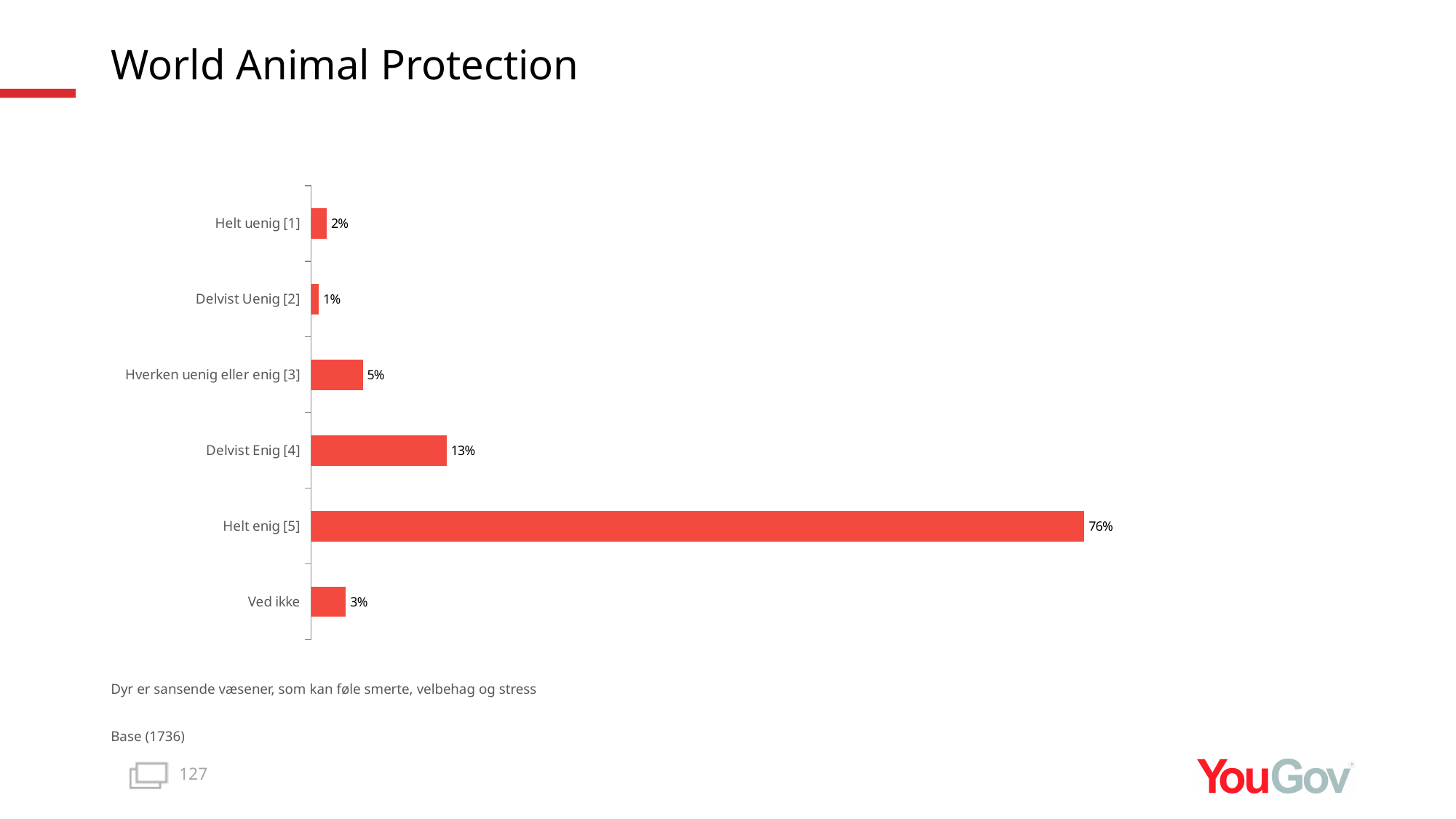
What is the value for Hverken uenig eller enig [3]? 5% What is the difference between the values for Helt uenig [1] and Delvist Uenig [2]? 1% Which category has the highest value? Helt enig [5] What is the value for Helt enig [5]? 76% Which is larger, the value for Hverken uenig eller enig [3] or the value for Ved ikke? Hverken uenig eller enig [3] What is the value for Ved ikke? 3% What is the value for Delvist Enig [4]? 13% How many categories are shown in the chart? 6 What is the difference between the values for Helt enig [5] and Delvist Enig [4]? 63% What kind of chart is shown on the slide? Bar chart What is the base size stated below the chart? 1736 Which category has the lowest value? Delvist Uenig [2]